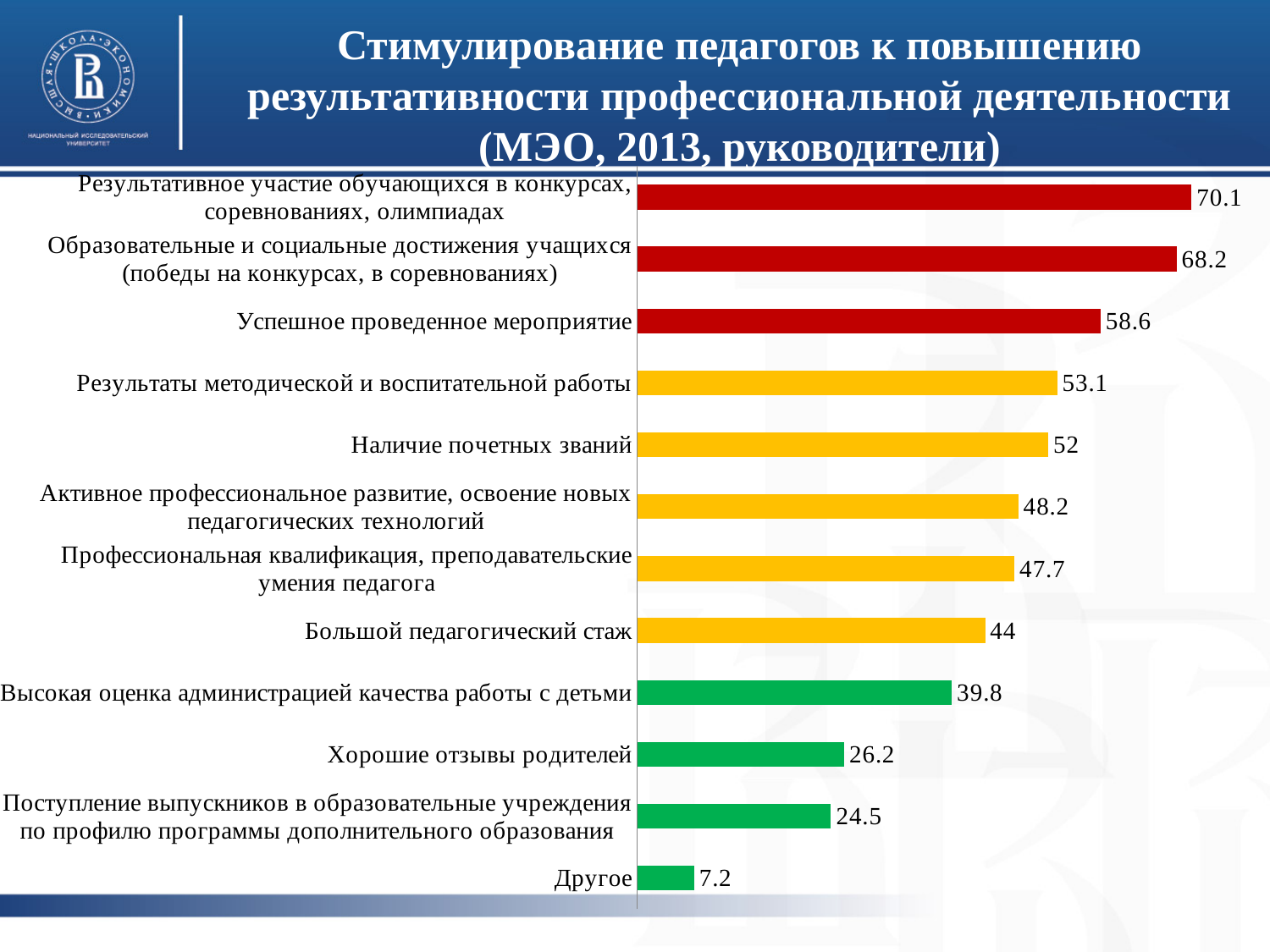
What is the value for «Поступление выпускников в образовательные учреждения по профилю программы дополнительного образования»? 24.5 How many bars are coloured red? 3 What is the difference between the values for «Большой педагогический стаж» and «Высокая оценка администрацией качества работы с детьми»? 4.2 How many categories are shown in the chart? 12 Which is larger: the value for «Результаты методической и воспитательной работы» or the value for «Активное профессиональное развитие, освоение новых педагогических технологий»? Результаты методической и воспитательной работы What is the value for «Наличие почетных званий»? 52 Which category has the lowest value? Другое Which category has the highest value? Результативное участие обучающихся в конкурсах, соревнованиях, олимпиадах What is the value for «Хорошие отзывы родителей»? 26.2 What is the difference between the values for «Результативное участие обучающихся в конкурсах, соревнованиях, олимпиадах» and «Образовательные и социальные достижения учащихся (победы на конкурсах, в соревнованиях)»? 1.9 What is the value for «Успешное проведенное мероприятие»? 58.6 What kind of chart is shown on the slide? Bar chart